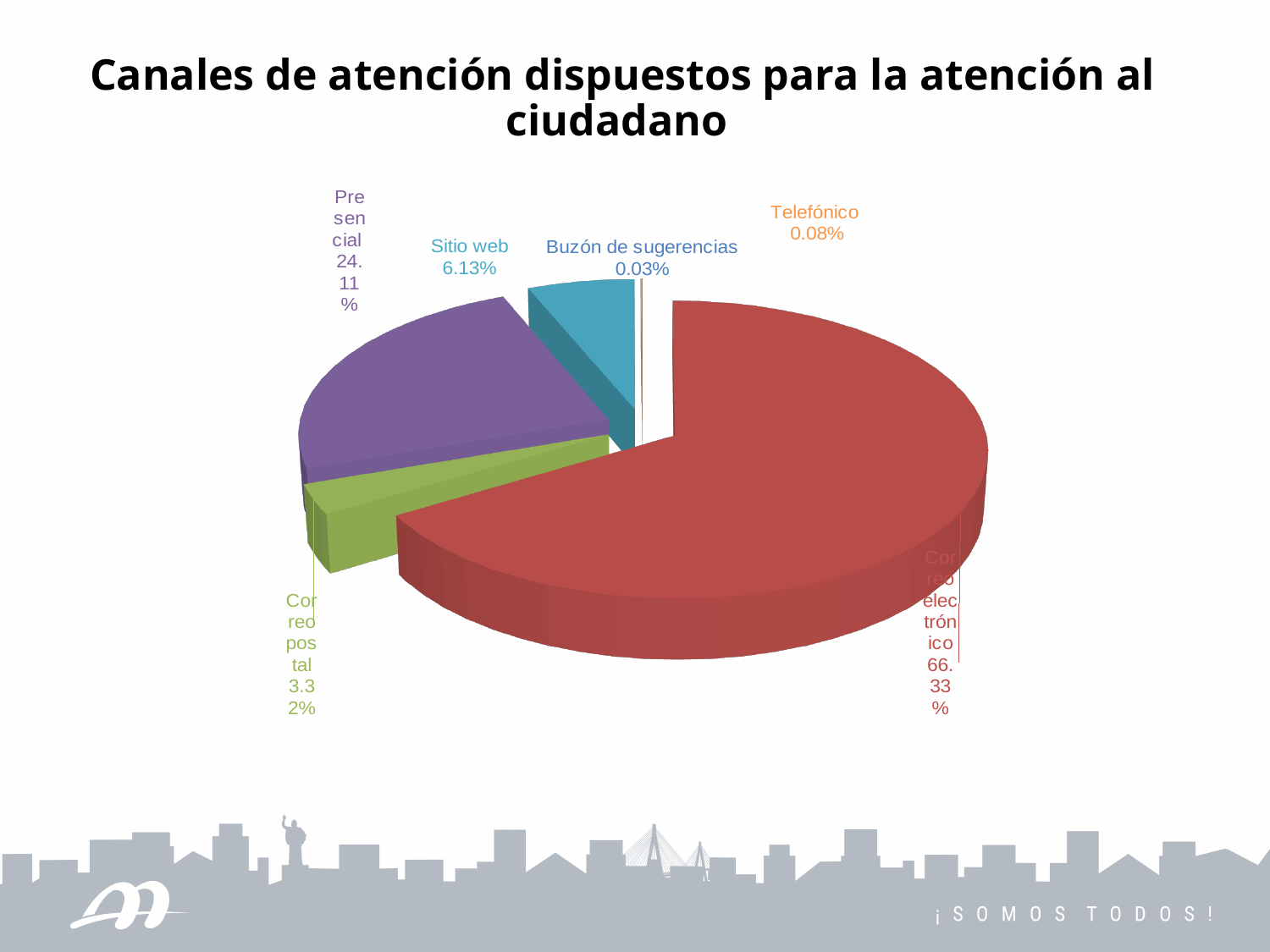
What kind of chart is shown on the slide? pie chart Which channel has the smallest share of the pie? Buzón de sugerencias How many channels (slices) are shown in the pie chart? 6 What percentage is shown for Correo postal? 3.32% What percentage is shown for Buzón de sugerencias? 0.03% What percentage is shown for Telefónico? 0.08% What percentage is shown for Sitio web? 6.13% What percentage is shown for Presencial? 24.11% Which is larger, the share for Sitio web or the share for Correo postal? Sitio web What is the title of the chart on the slide? Canales de atención dispuestos para la atención al ciudadano What percentage is shown for Correo electrónico? 66.33% Which channel has the largest share of the pie? Correo electrónico